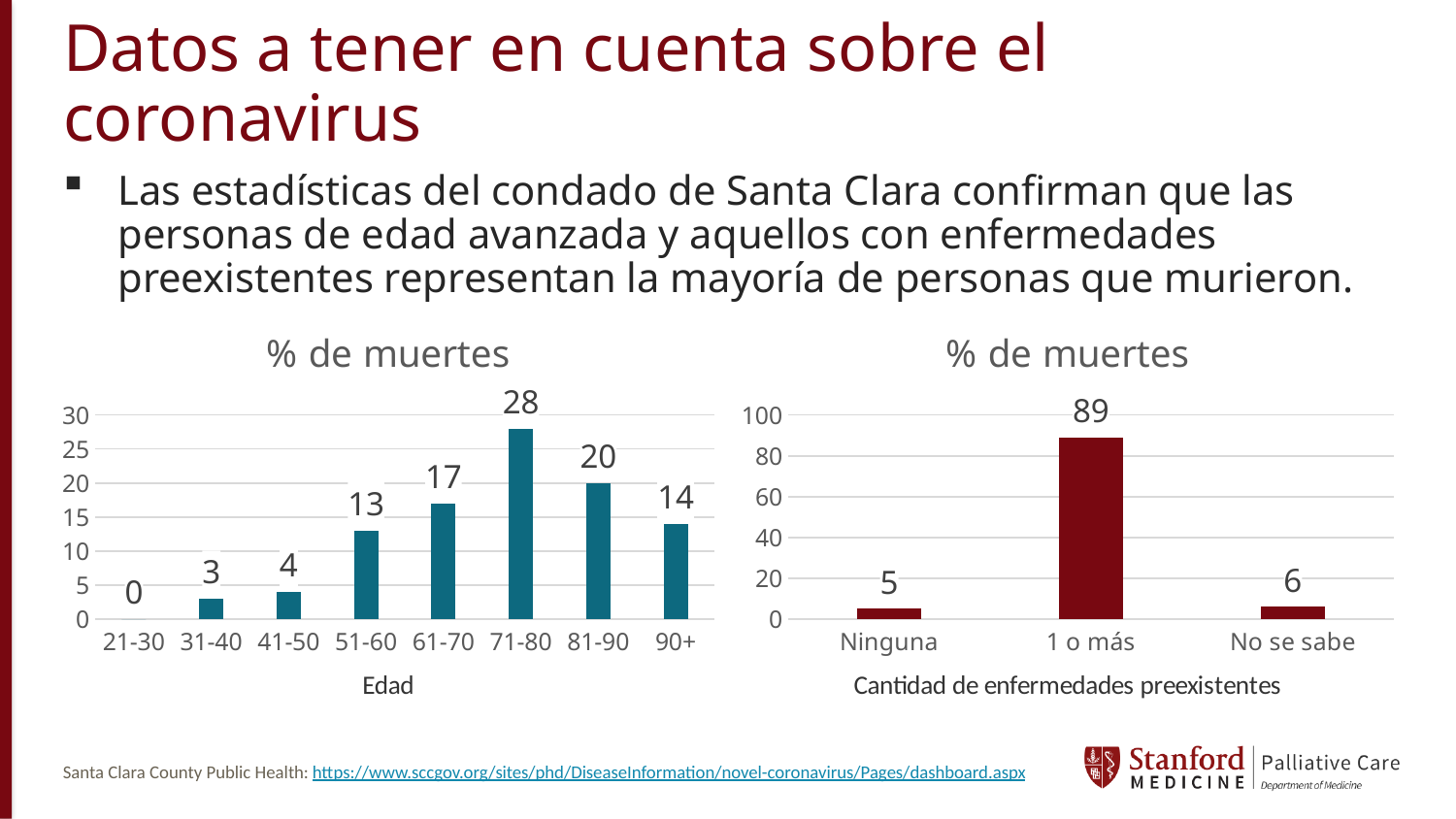
In the left chart (x axis 'Edad'), which is larger, the value for 61-70 or the value for 81-90? 81-90 In the right chart (x axis 'Cantidad de enfermedades preexistentes'), what is the value for '1 o más'? 89 In the right chart (x axis 'Cantidad de enfermedades preexistentes'), what is the difference between the values for '1 o más' and 'No se sabe'? 83 In the left chart (x axis 'Edad'), what is the value for the 51-60 age group? 13 In the left chart (x axis 'Edad'), which age group has the lowest value? 21-30 In the left chart (x axis 'Edad'), what is the value for the 71-80 age group? 28 In the right chart (x axis 'Cantidad de enfermedades preexistentes'), which category has the lowest value? Ninguna How many age groups are shown in the left chart (x axis 'Edad')? 8 What is the title of the left chart (x axis 'Edad')? % de muertes In the left chart (x axis 'Edad'), what is the difference between the values for 81-90 and 90+? 6 What kind of chart is the right chart (x axis 'Cantidad de enfermedades preexistentes')? Bar chart In the left chart (x axis 'Edad'), which age group has the highest value? 71-80